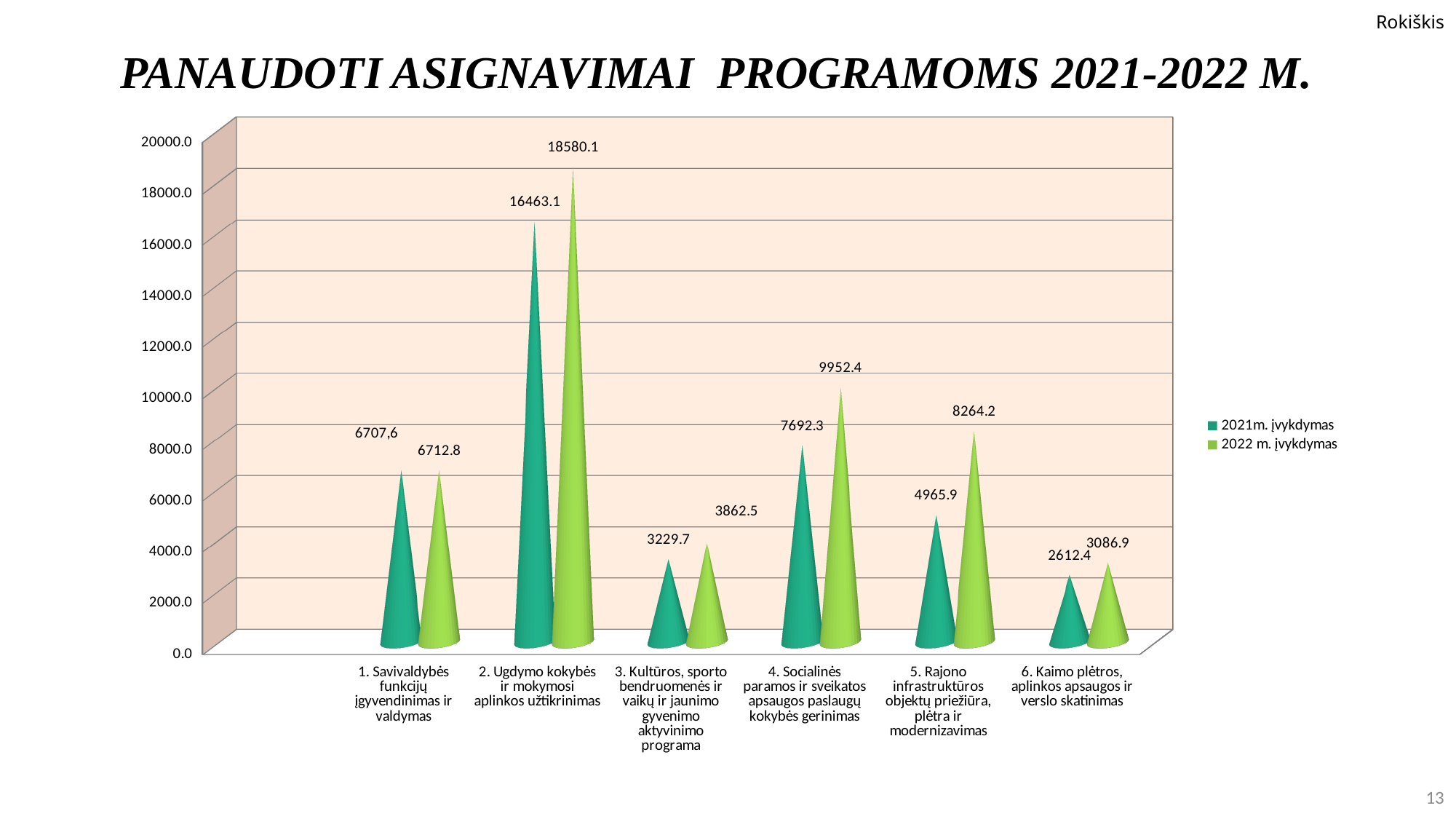
What is the 2021m. įvykdymas value for '4. Socialinės paramos ir sveikatos apsaugos paslaugų kokybės gerinimas'? 7692.3 What is the 2022 m. įvykdymas value for '6. Kaimo plėtros, aplinkos apsaugos ir verslo skatinimas'? 3086.9 What is the 2021m. įvykdymas value for '1. Savivaldybės funkcijų įgyvendinimas ir valdymas'? 6707,6 How many series does the legend list? 2 Which program has the highest 2022 m. įvykdymas value? 2. Ugdymo kokybės ir mokymosi aplinkos užtikrinimas What is the difference between the 2022 and 2021 values for '2. Ugdymo kokybės ir mokymosi aplinkos užtikrinimas'? 2117.0 What is the 2022 m. įvykdymas value for '2. Ugdymo kokybės ir mokymosi aplinkos užtikrinimas'? 18580.1 Which is larger for '3. Kultūros, sporto bendruomenės ir vaikų ir jaunimo gyvenimo aktyvinimo programa': the 2021 value or the 2022 value? 2022 value What kind of chart is shown on the slide? Bar chart What is the difference between the 2022 and 2021 values for '5. Rajono infrastruktūros objektų priežiūra, plėtra ir modernizavimas'? 3298.3 Which program has the lowest 2021m. įvykdymas value? 6. Kaimo plėtros, aplinkos apsaugos ir verslo skatinimas How many programs (categories) are shown on the x axis? 6